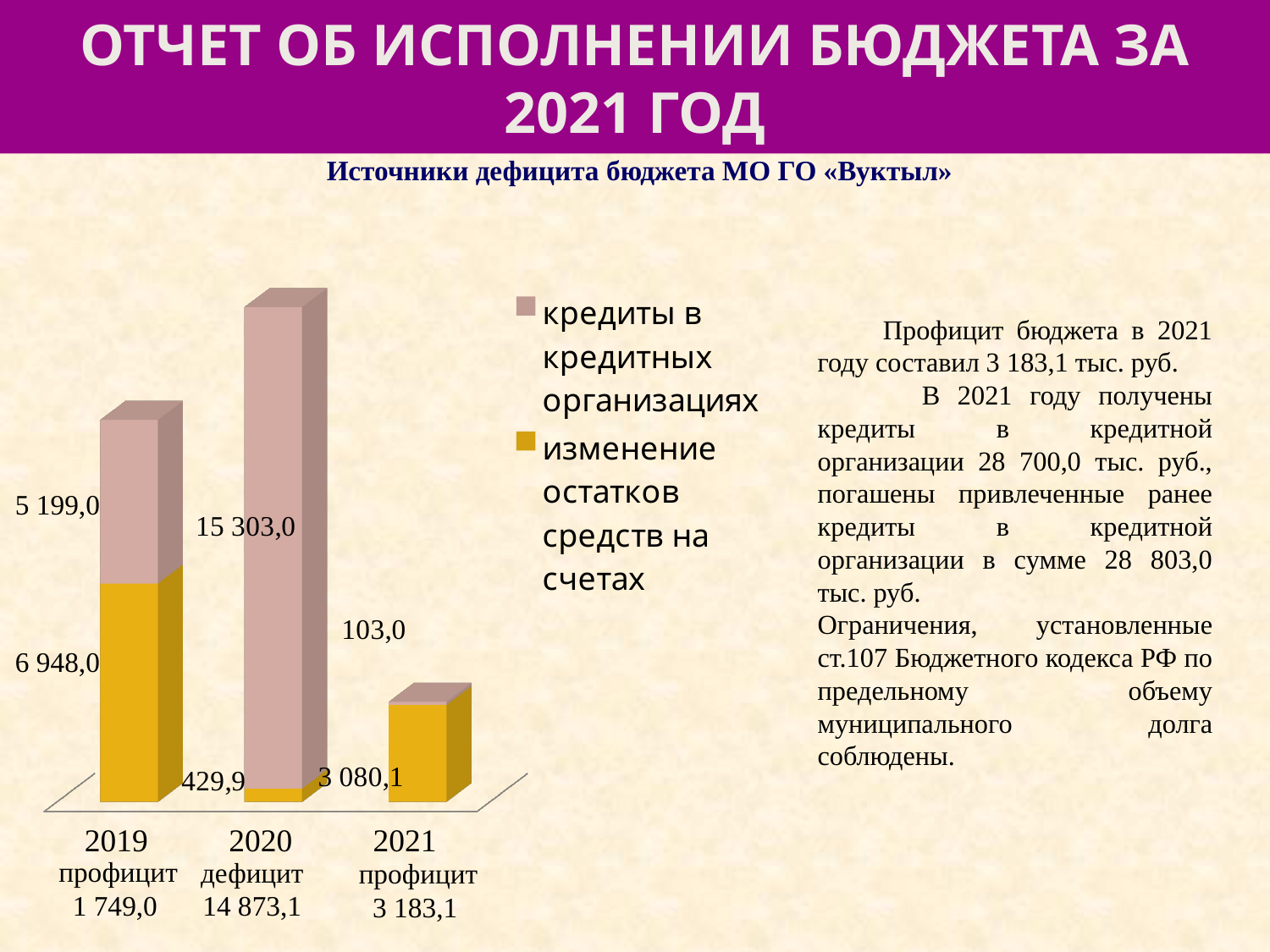
What is the difference between the "кредиты в кредитных организациях" values for 2020 and 2019? 10 104,0 What is the total of the stacked bar for 2021? 3 183,1 Which is larger in 2019: "кредиты в кредитных организациях" or "изменение остатков средств на счетах"? изменение остатков средств на счетах How many series does the chart legend list? 2 What is the value for "изменение остатков средств на счетах" in 2019? 6 948,0 What is the value for "кредиты в кредитных организациях" in 2021? 103,0 How many years (categories) are shown on the x axis of the chart? 3 In which year is the value for "кредиты в кредитных организациях" the highest? 2020 What is the value for "кредиты в кредитных организациях" in 2020? 15 303,0 What is the value for "изменение остатков средств на счетах" in 2020? 429,9 In which year is the value for "изменение остатков средств на счетах" the lowest? 2020 What type of chart is shown on the slide? stacked bar chart